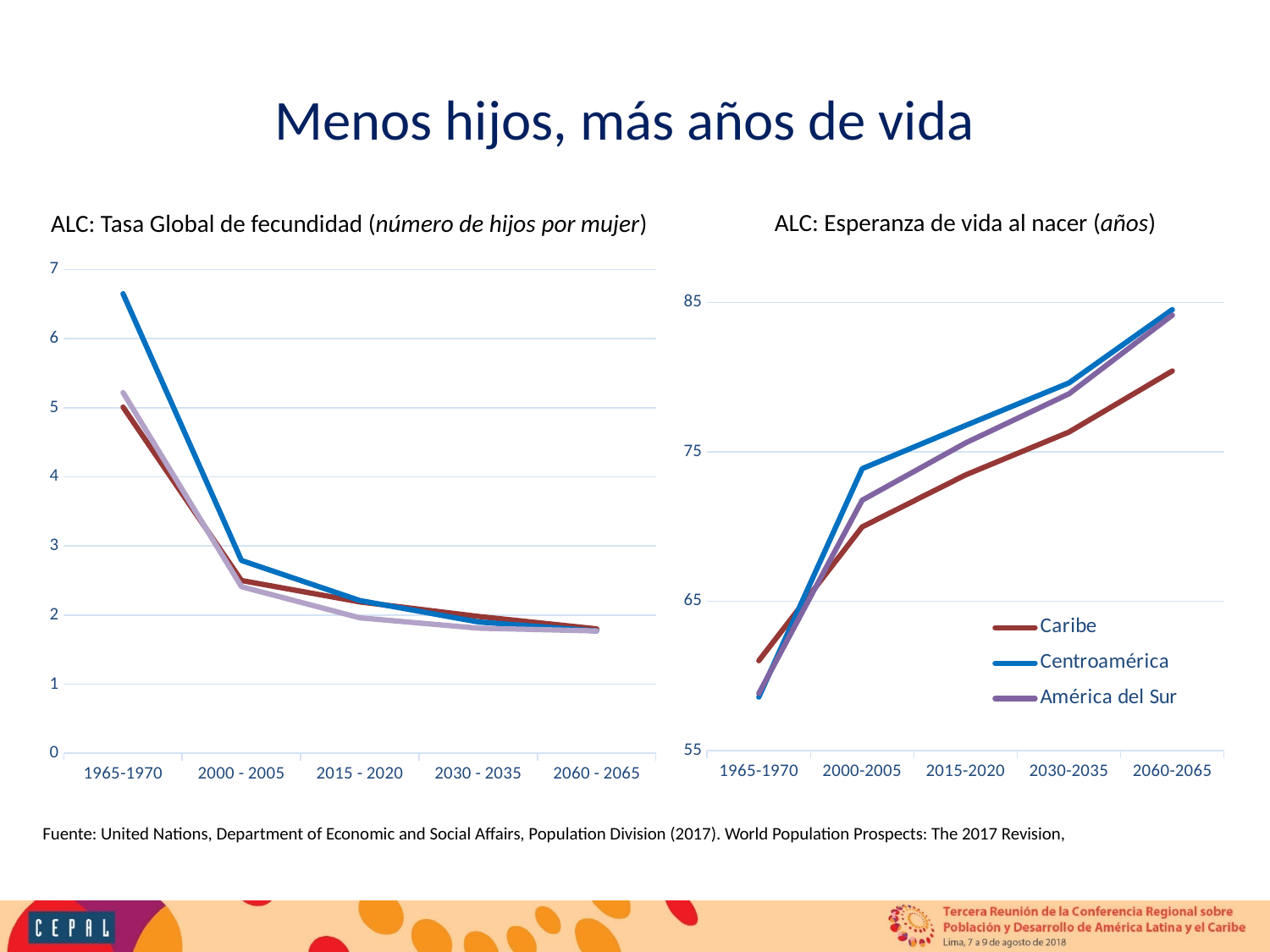
In the right chart, 'ALC: Esperanza de vida al nacer', which is larger in 2000-2005: Caribe or Centroamérica? Centroamérica In the left chart, 'ALC: Tasa Global de fecundidad', do the values rise or fall from 1965-1970 to 2060-2065? fall What type of chart is the left chart, 'ALC: Tasa Global de fecundidad'? line chart What is the title of the right chart on the slide? ALC: Esperanza de vida al nacer (años) In the right chart, 'ALC: Esperanza de vida al nacer', do the values rise or fall from 1965-1970 to 2060-2065? rise How many series does the legend of the right chart, 'ALC: Esperanza de vida al nacer', list? 3 In the right chart, 'ALC: Esperanza de vida al nacer', is the value for Caribe in 2060-2065 greater or less than 75? greater In the right chart, 'ALC: Esperanza de vida al nacer', which series has the lowest value in 2060-2065? Caribe In the right chart, 'ALC: Esperanza de vida al nacer', which series has the highest value in 1965-1970? Caribe In the right chart, 'ALC: Esperanza de vida al nacer', is the value for Centroamérica in 1965-1970 greater or less than 65? less How many periods are shown on the x axis of the right chart, 'ALC: Esperanza de vida al nacer'? 5 In the left chart, 'ALC: Tasa Global de fecundidad', is the value of the blue line in 1965-1970 greater or less than 6? greater